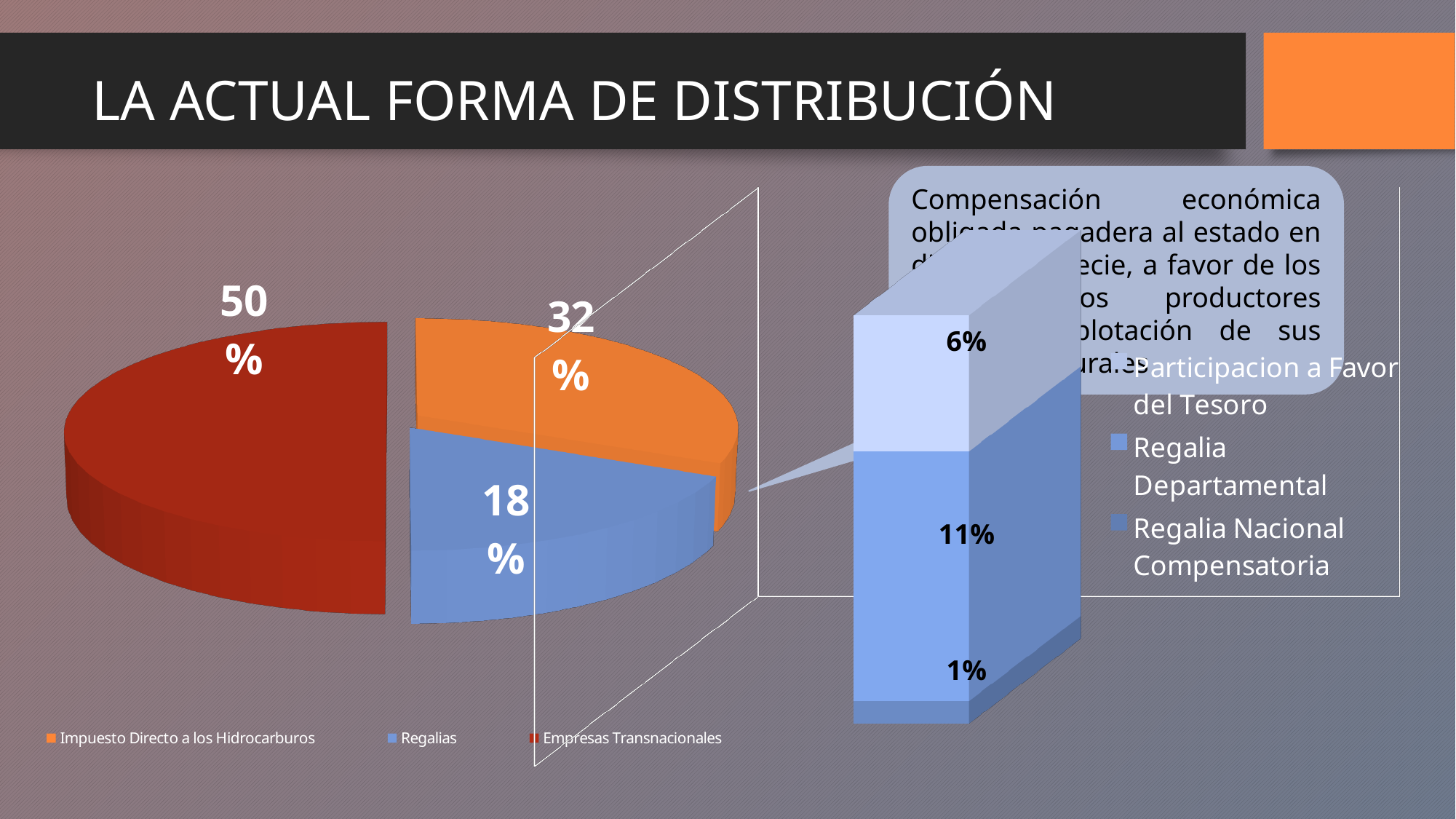
What share of the pie is labelled for Regalias? 18% In the breakdown bar of the Regalias slice, what value is shown for Regalia Nacional Compensatoria? 1% Which is larger, the slice for Impuesto Directo a los Hidrocarburos or the slice for Regalias? Impuesto Directo a los Hidrocarburos What share of the pie is labelled for Empresas Transnacionales? 50% What is the total of the three segments in the breakdown bar (6%, 11% and 1%)? 18% Which category has the largest slice of the pie? Empresas Transnacionales What share of the pie is labelled for Impuesto Directo a los Hidrocarburos? 32% What kind of chart is shown on the slide? A pie chart and a stacked bar chart Which category has the smallest slice of the pie? Regalias In the breakdown bar of the Regalias slice, what value is shown for Participacion a Favor del Tesoro? 6% What is the difference in percentage points between the Empresas Transnacionales slice and the Regalias slice? 32 In the breakdown bar of the Regalias slice, what value is shown for Regalia Departamental? 11%